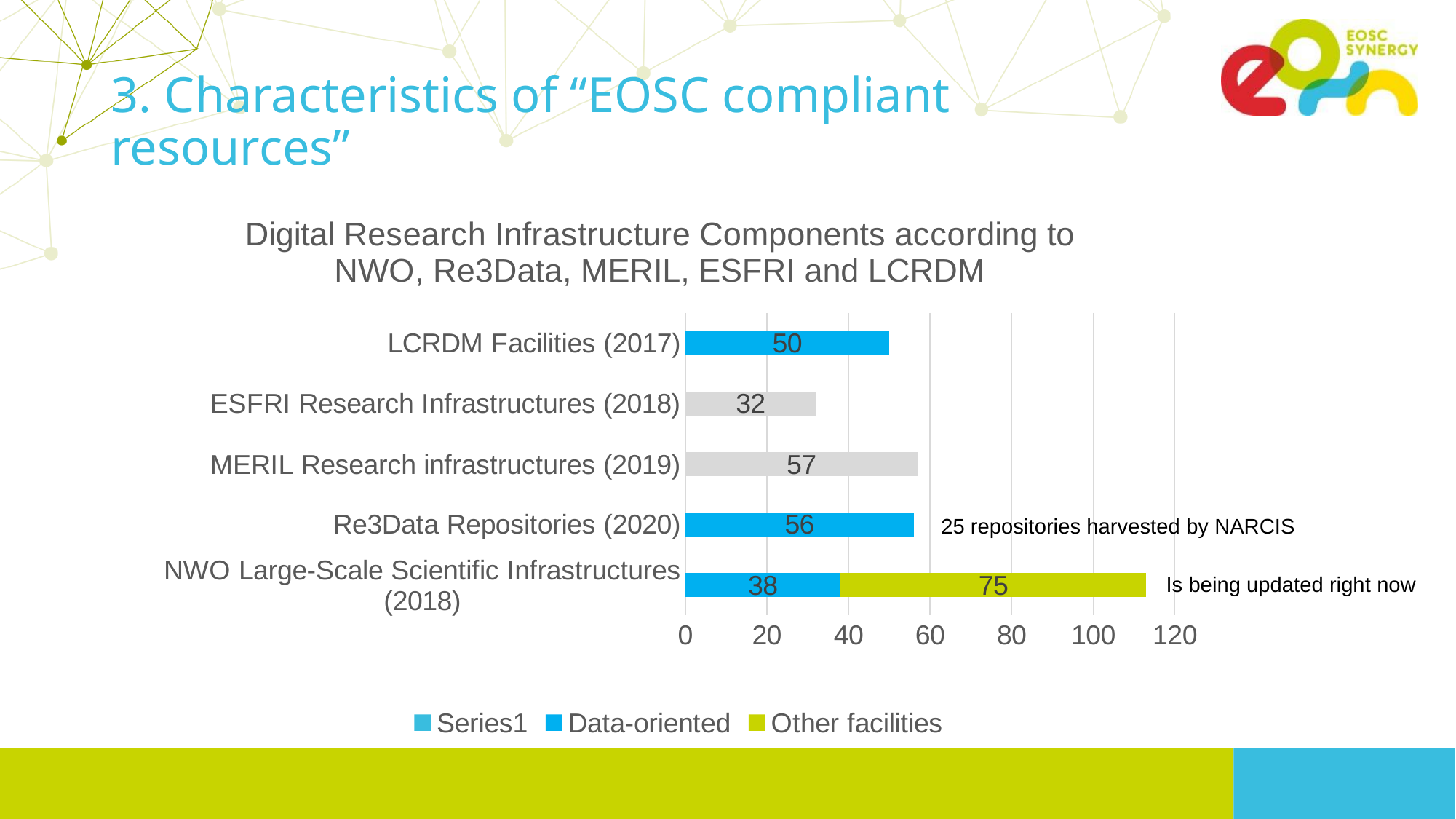
Which category has the longest bar overall? NWO Large-Scale Scientific Infrastructures (2018) Which category has the lowest value? ESFRI Research Infrastructures (2018) What is the value for LCRDM Facilities (2017)? 50 What is the difference between the values for MERIL Research infrastructures (2019) and ESFRI Research Infrastructures (2018)? 25 Which is larger, the value for LCRDM Facilities (2017) or ESFRI Research Infrastructures (2018)? LCRDM Facilities (2017) What is the value for ESFRI Research Infrastructures (2018)? 32 What is the value for MERIL Research infrastructures (2019)? 57 What is the total of the stacked bar for NWO Large-Scale Scientific Infrastructures (2018)? 113 What is the Data-oriented value for NWO Large-Scale Scientific Infrastructures (2018)? 38 How many categories are shown on the chart? 5 How many series does the legend list? 3 What is the Other facilities value for NWO Large-Scale Scientific Infrastructures (2018)? 75